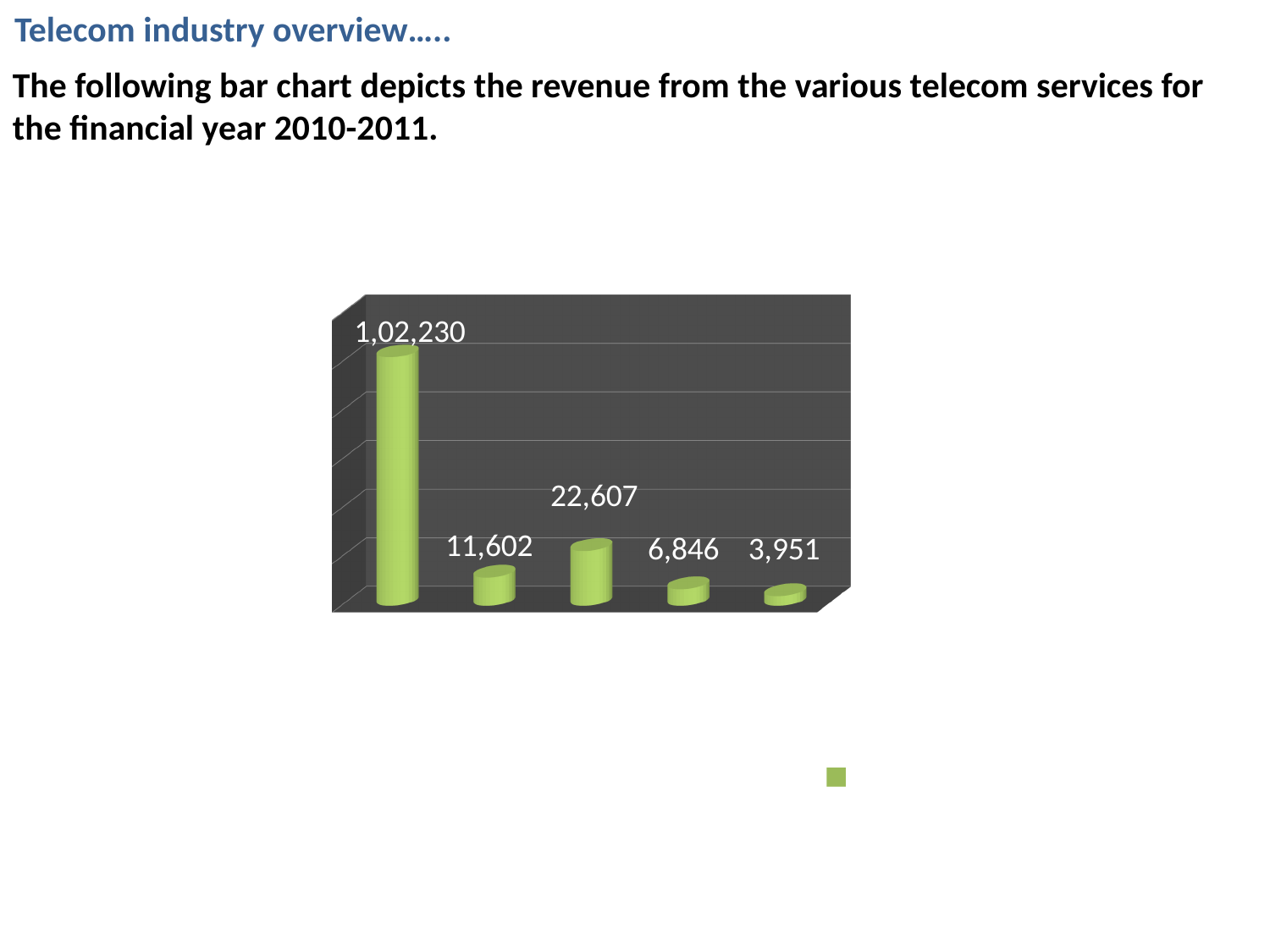
What is the value shown on the third bar from the left? 22,607 What is the value shown on the fourth bar from the left? 6,846 Which bar has the lowest value? the last (rightmost) bar, 3,951 What is the value shown on the first (leftmost) bar? 1,02,230 How many bars are plotted in the chart? 5 What colour are the bars in the chart? green Which is larger, the value of the second bar or the value of the third bar? the third bar (22,607) What is the difference between the third bar (22,607) and the second bar (11,602)? 11,005 What is the value shown on the last (rightmost) bar? 3,951 Which bar has the highest value? the first (leftmost) bar, 1,02,230 What is the value shown on the second bar from the left? 11,602 What kind of chart is shown on the slide? bar chart